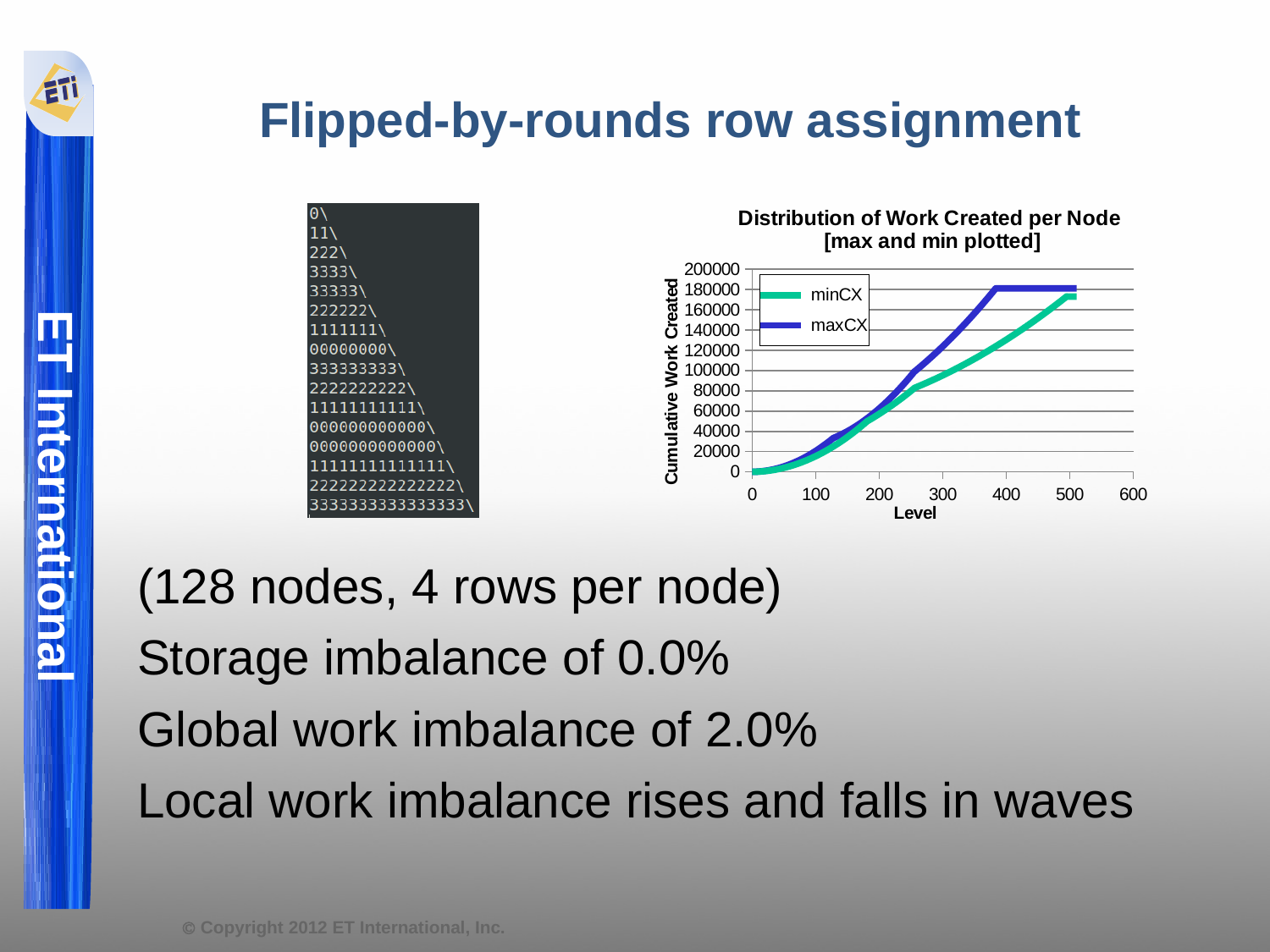
What kind of chart is shown on the slide? line chart Which series reaches the highest value on the chart? maxCX At Level 300, which series has the larger value, minCX or maxCX? maxCX At Level 400, which series has the larger value, minCX or maxCX? maxCX What is the title of the chart? Distribution of Work Created per Node [max and min plotted] What is the label of the x axis of the chart? Level Do the values of the maxCX series rise or fall as Level increases? rise Is the value for minCX at Level 100 greater or less than 40000? less Do the values of the minCX series rise or fall as Level increases? rise Is the value for maxCX at Level 500 greater or less than 160000? greater Is the value for minCX at Level 500 greater or less than 140000? greater How many series does the legend of the chart list? 2